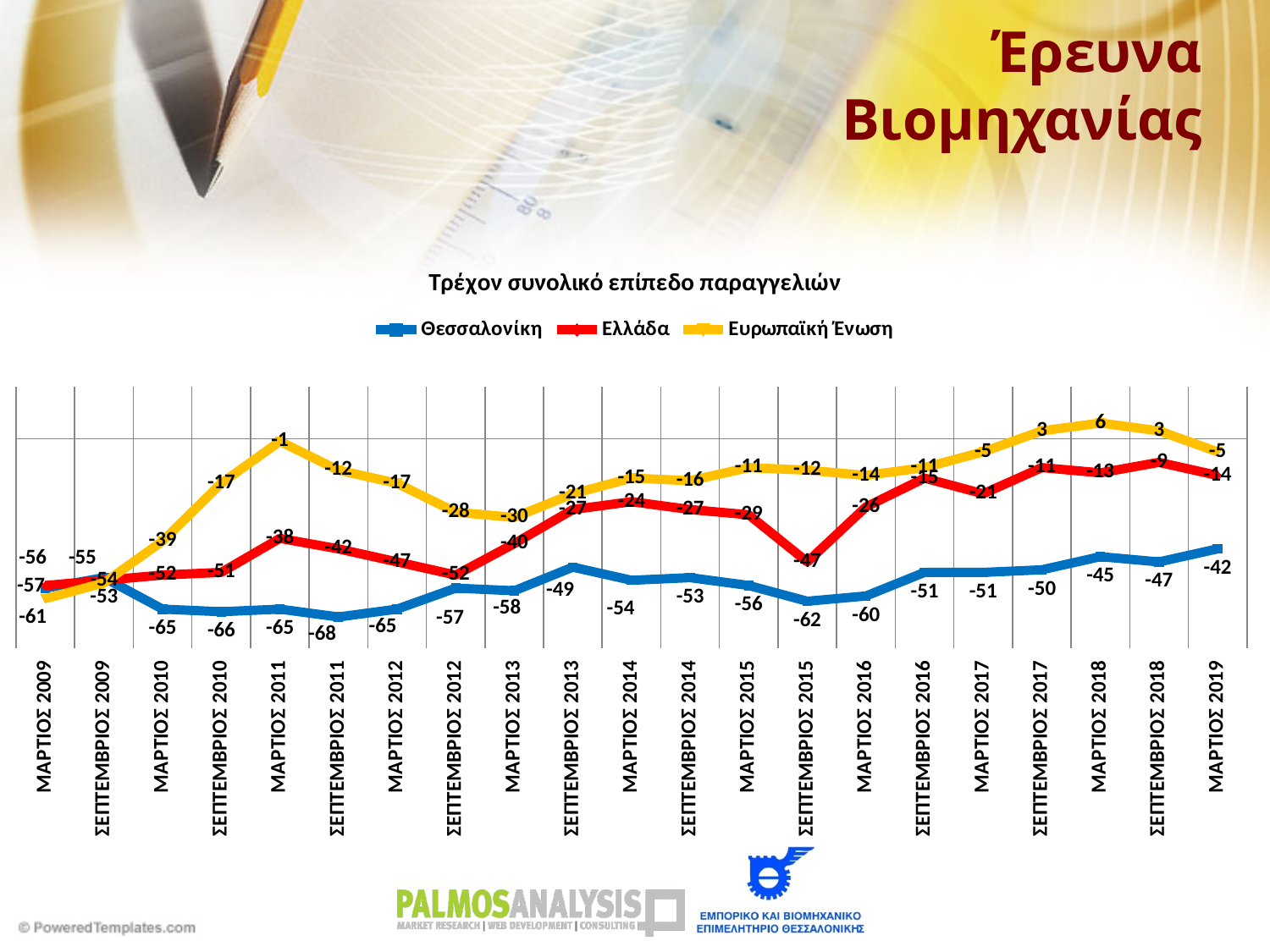
In which period does the Ευρωπαϊκή Ένωση series reach its highest value? ΜΑΡΤΙΟΣ 2018 How many series does the legend list? 3 Does the Θεσσαλονίκη series generally rise or fall from ΣΕΠΤΕΜΒΡΙΟΣ 2015 to ΜΑΡΤΙΟΣ 2019? rise What is the value for Ελλάδα in ΣΕΠΤΕΜΒΡΙΟΣ 2015? -47 What is the title of the chart? Τρέχον συνολικό επίπεδο παραγγελιών How many time points are plotted along the x axis? 21 Which series has the higher value in ΣΕΠΤΕΜΒΡΙΟΣ 2013, Ελλάδα or Ευρωπαϊκή Ένωση? Ευρωπαϊκή Ένωση What is the difference between the Ελλάδα and Θεσσαλονίκη values in ΜΑΡΤΙΟΣ 2019? 28 What kind of chart is shown on the slide? line chart What is the value for Θεσσαλονίκη in ΜΑΡΤΙΟΣ 2019? -42 In which period does the Θεσσαλονίκη series reach its lowest value? ΣΕΠΤΕΜΒΡΙΟΣ 2011 What is the value for Ευρωπαϊκή Ένωση in ΜΑΡΤΙΟΣ 2011? -1